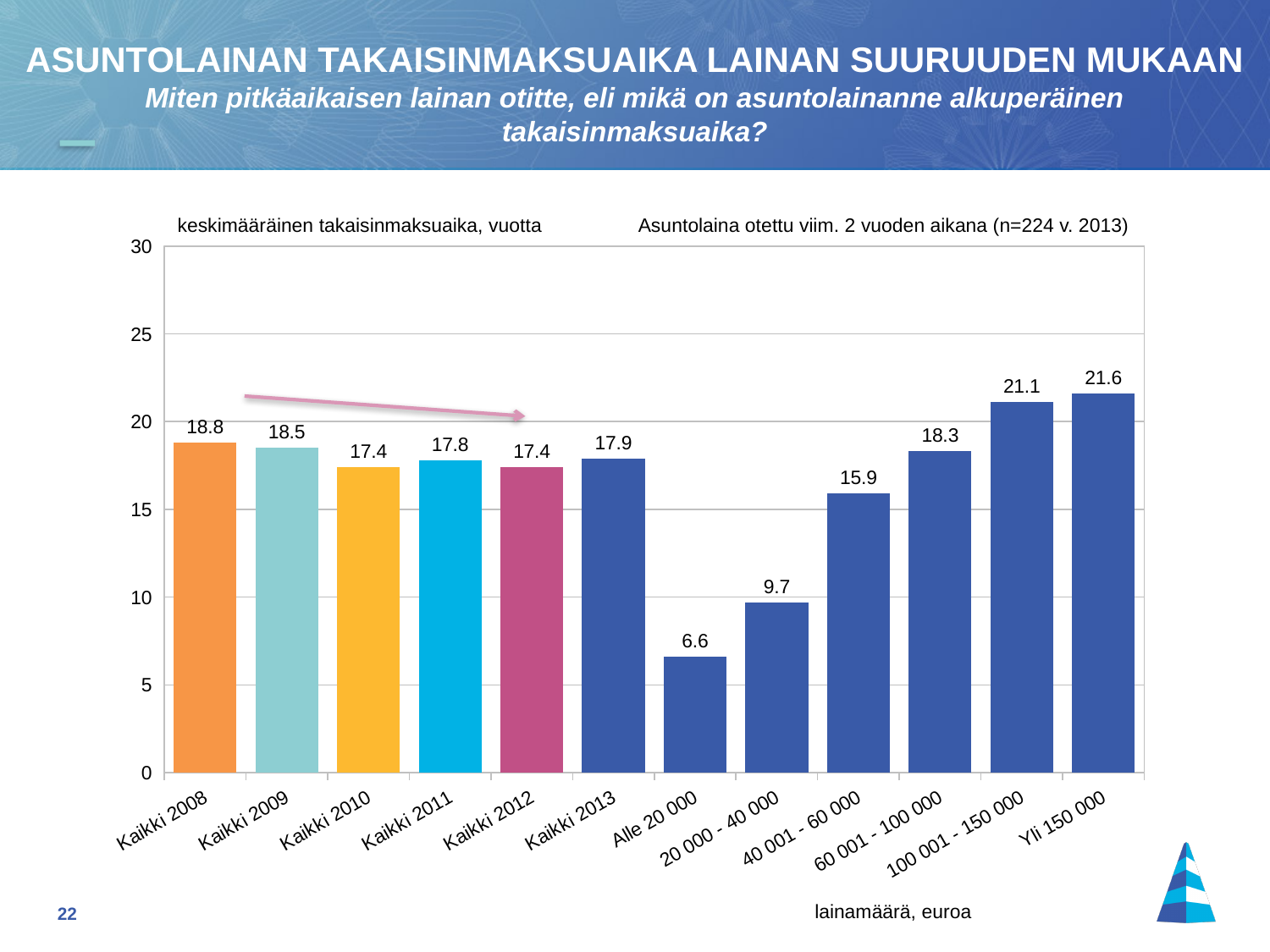
What is the value for the Alle 20 000 loan category? 6.6 Is the value for 100 001 - 150 000 greater or less than 20? greater Which category has the highest value? Yli 150 000 What is the value for 60 001 - 100 000? 18.3 What type of chart is shown on the slide? bar chart Which category has the lowest value? Alle 20 000 What is the value for Yli 150 000? 21.6 Which is larger, the value for 20 000 - 40 000 or 40 001 - 60 000? 40 001 - 60 000 What is the average repayment period for Kaikki 2008? 18.8 How many bars are shown in the chart? 12 What is the difference between Kaikki 2008 and Kaikki 2013? 0.9 What is the difference between the values for Yli 150 000 and Alle 20 000? 15.0